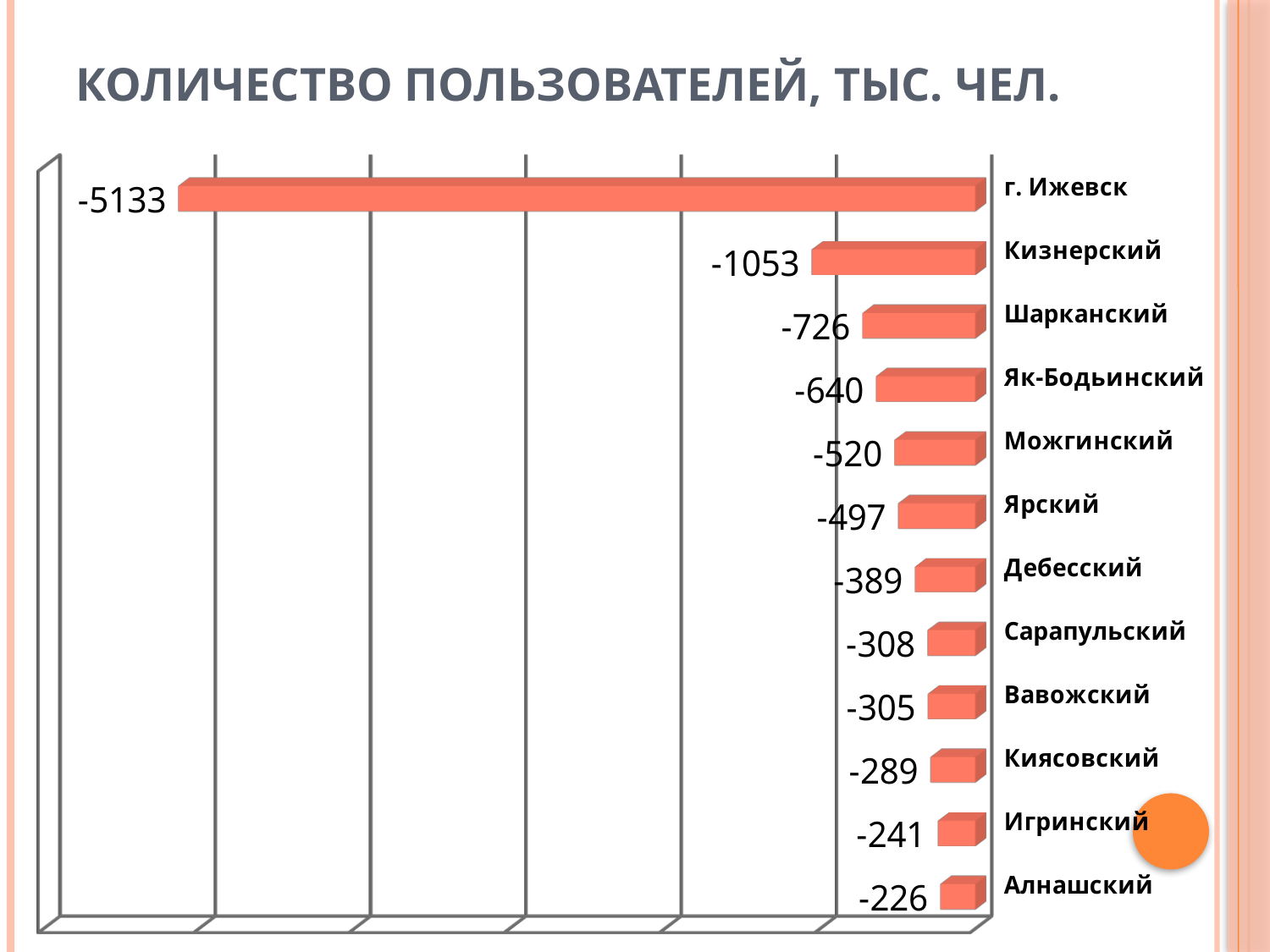
What is the title of the chart? КОЛИЧЕСТВО ПОЛЬЗОВАТЕЛЕЙ, ТЫС. ЧЕЛ. What kind of chart is shown on the slide? Bar chart What is the value shown for Алнашский? -226 Which category has the shortest bar (smallest absolute value)? Алнашский What is the difference between the values for Як-Бодьинский and Ярский? 143 What is the value shown for г. Ижевск? -5133 What is the difference between the values for Кизнерский and Шарканский? 327 What is the value shown for Можгинский? -520 How many categories are shown in the chart? 12 Which has the larger absolute value, Дебесский or Киясовский? Дебесский What is the value shown for Кизнерский? -1053 Which category has the longest bar (largest absolute value)? г. Ижевск